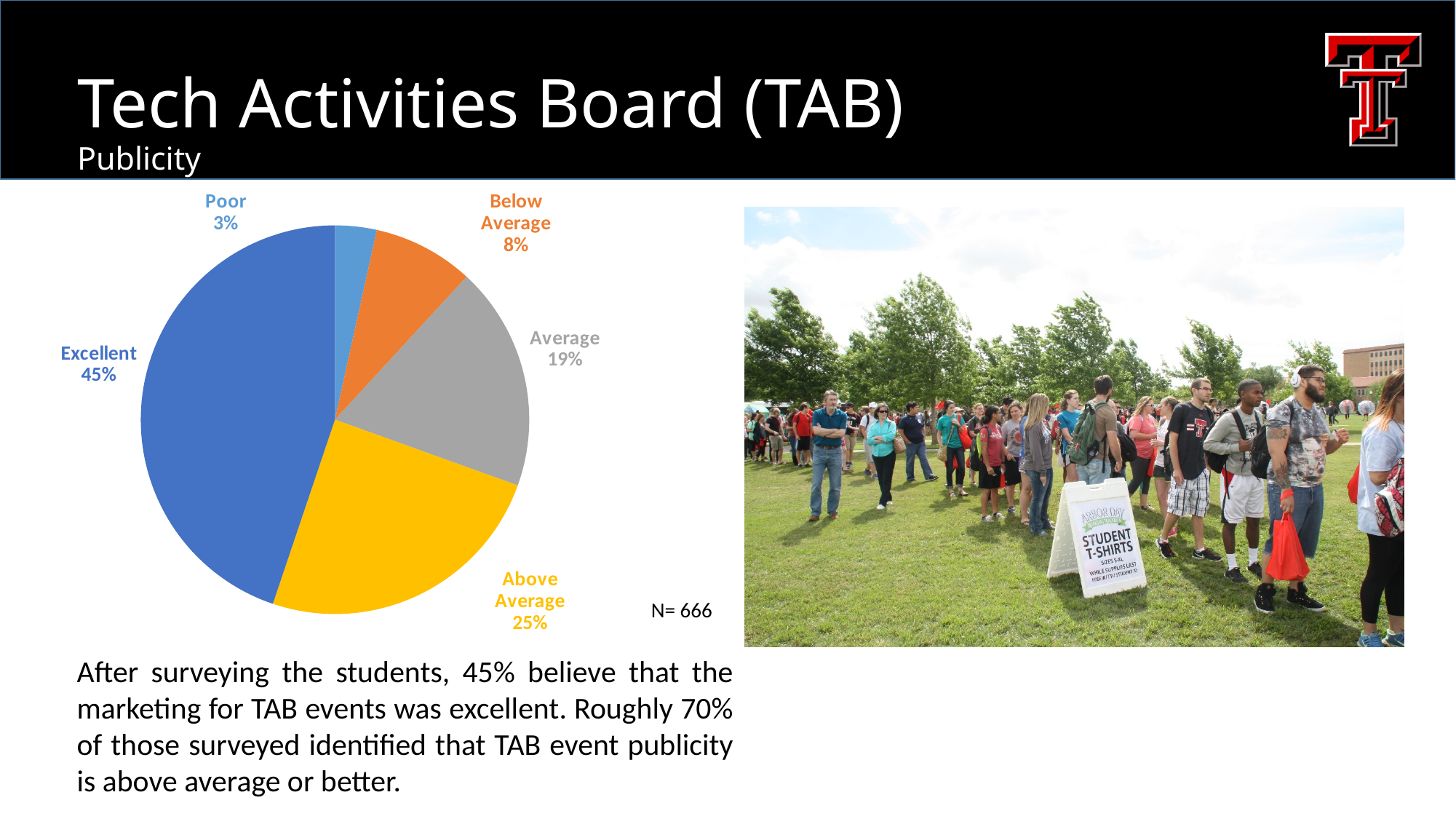
How many categories does the pie chart show? 5 What percentage of respondents rated TAB publicity as Average? 19% What percentage of respondents rated TAB publicity as Poor? 3% Which rating category has the largest share of the pie? Excellent What sample size (N) is shown next to the pie chart? N= 666 Which is larger, the share for Below Average or the share for Average? Average What percentage of respondents rated TAB publicity as Excellent? 45% What is the combined share of Excellent and Above Average? 70% Which rating category has the smallest share of the pie? Poor What kind of chart is shown on the slide? pie chart What is the difference in percentage points between Above Average and Average? 6 What percentage of respondents rated TAB publicity as Below Average? 8%